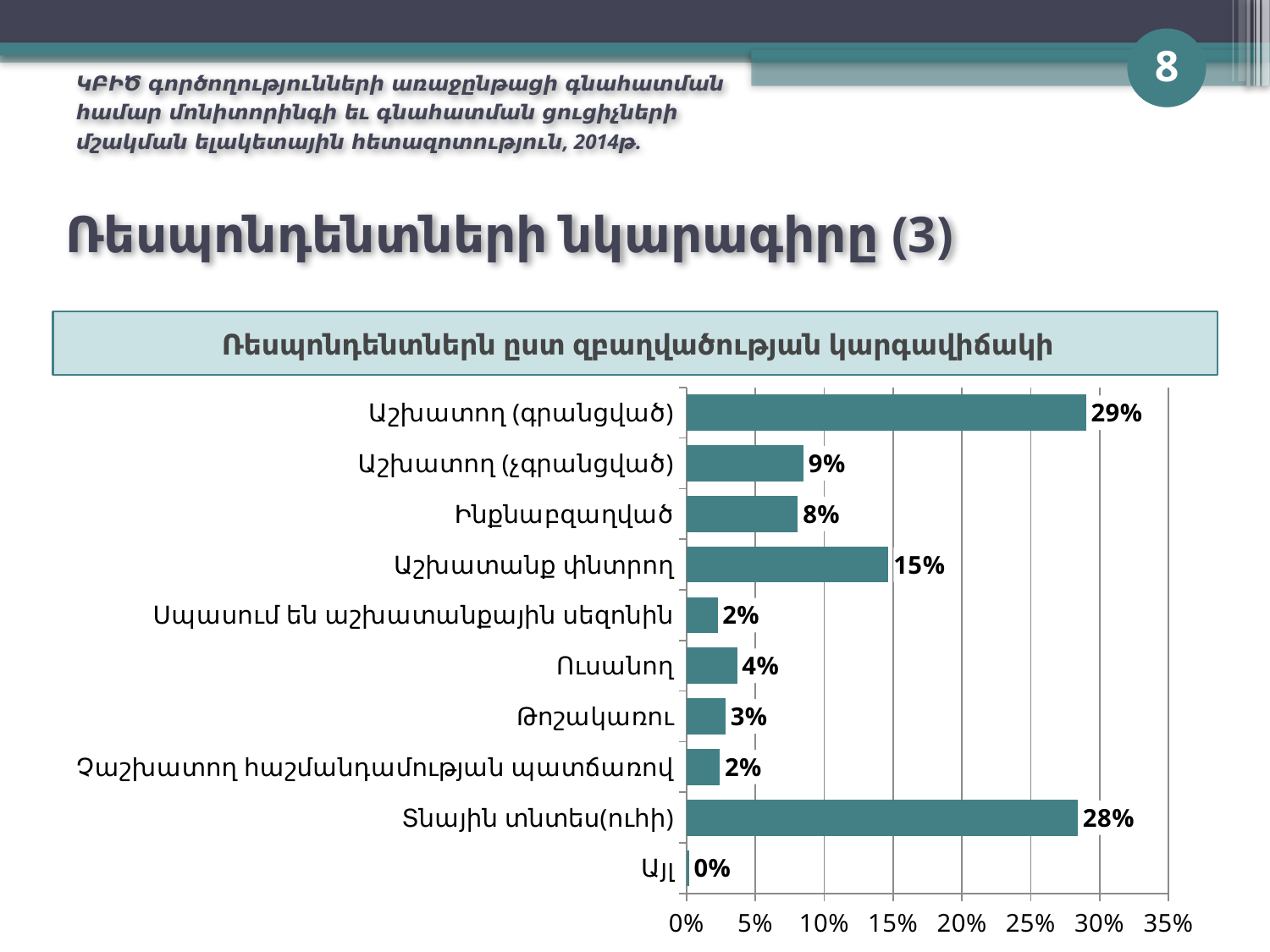
What type of chart is shown on the slide? bar chart Which category has the lowest value? Այլ What is the title of the chart? Ռեսպոնդենտներն ըստ զբաղվածության կարգավիճակի How many categories are shown in the chart? 10 What is the difference between the values for Աշխատանք փնտրող and Ինքնազբաղված? 7% What is the value for Աշխատող (գրանցված)? 29% What is the difference between the values for Աշխատող (գրանցված) and Տնային տնտես(ուհի)? 1% What is the value for Աշխատանք փնտրող? 15% Which is larger, the value for Աշխատող (չգրանցված) or the value for Ուսանող? Աշխատող (չգրանցված) What is the value for Տնային տնտես(ուհի)? 28% Which category has the highest value? Աշխատող (գրանցված) What is the value for Ուսանող? 4%